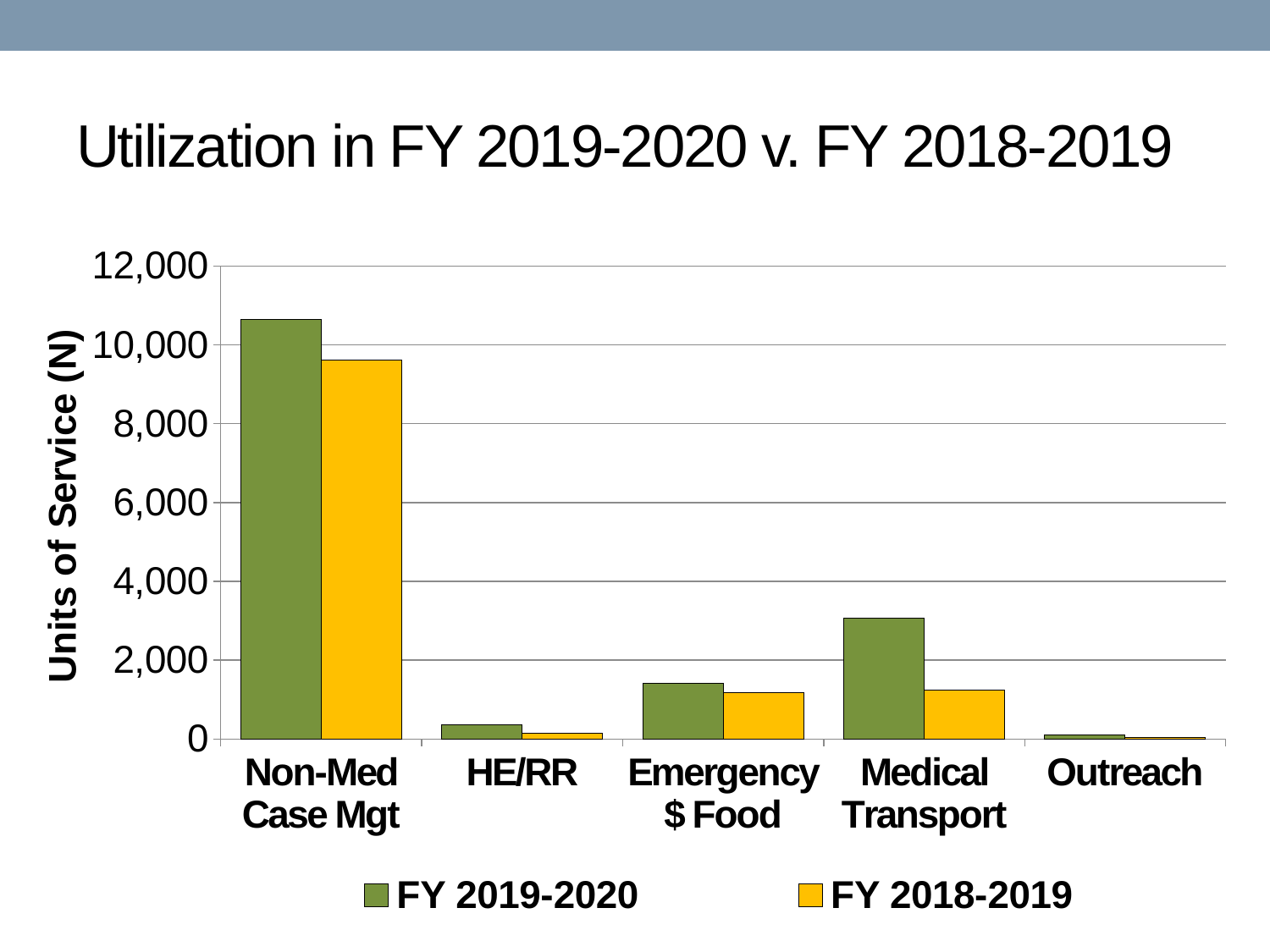
Is the FY 2019-2020 value for Non-Med Case Mgt greater or less than 10,000? greater Is the FY 2018-2019 value for Non-Med Case Mgt greater or less than 10,000? less For Medical Transport, which is larger: the FY 2019-2020 value or the FY 2018-2019 value? FY 2019-2020 What kind of chart is shown on the slide? bar chart What is the label on the vertical axis? Units of Service (N) Is the FY 2018-2019 value for Medical Transport greater or less than 2,000? less Which category has the highest FY 2019-2020 value? Non-Med Case Mgt Which category has the lowest FY 2018-2019 value? Outreach Which is larger for FY 2019-2020: Emergency $ Food or Medical Transport? Medical Transport How many series does the legend list? 2 How many service categories are shown on the x axis? 5